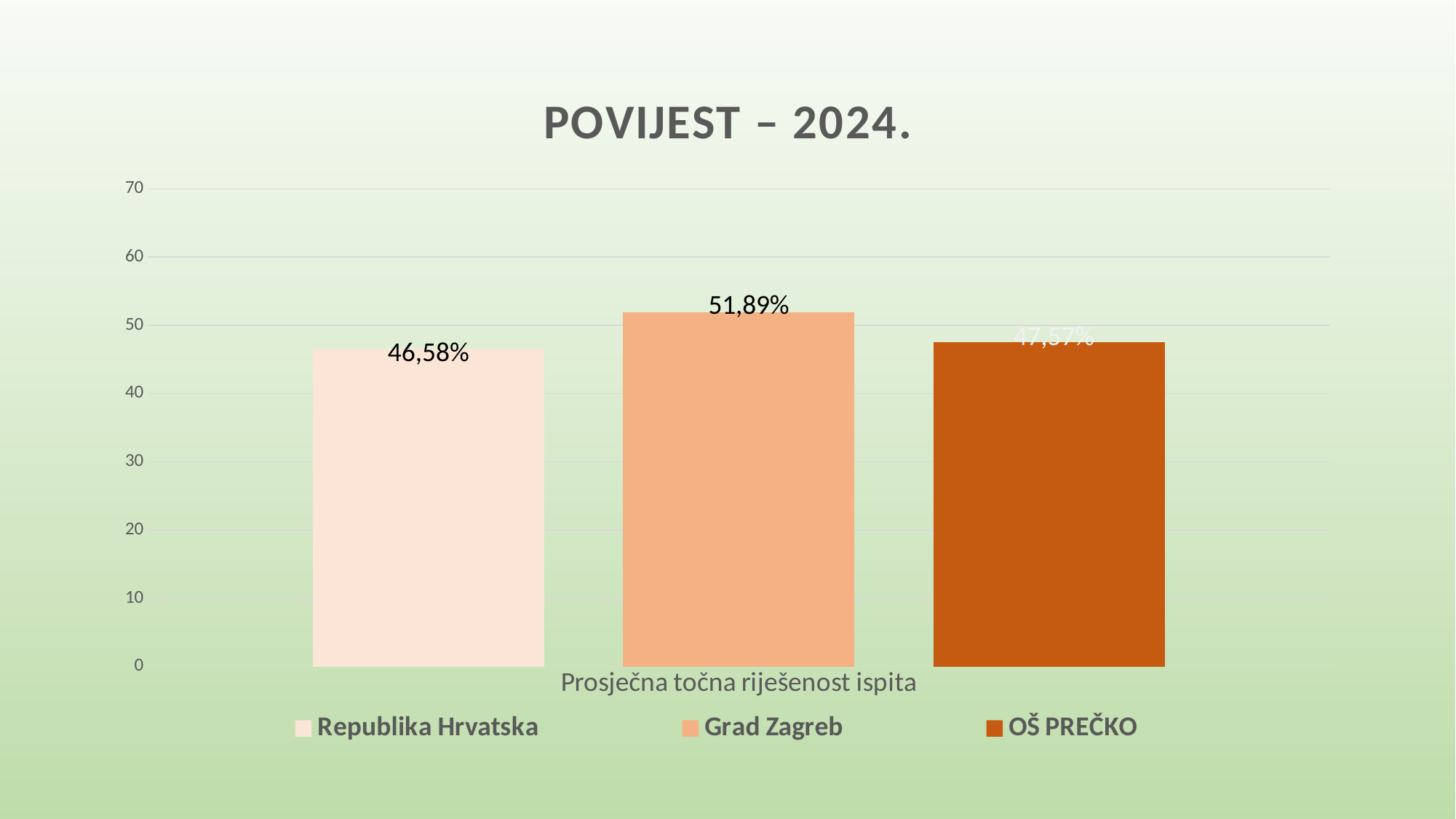
What is the difference between the values for OŠ PREČKO and Republika Hrvatska? 0,99% What is the value for Republika Hrvatska? 46,58% How many series does the legend list? 3 Which is larger, the value for Grad Zagreb or the value for OŠ PREČKO? Grad Zagreb What is the value for Grad Zagreb? 51,89% What is the title of the chart? POVIJEST – 2024. What is the value for OŠ PREČKO? 47,57% What kind of chart is shown on the slide? bar chart Is the value for Grad Zagreb greater or less than 50? greater Which series has the lowest value? Republika Hrvatska What is the difference between the values for Grad Zagreb and Republika Hrvatska? 5,31% Which series has the highest value? Grad Zagreb